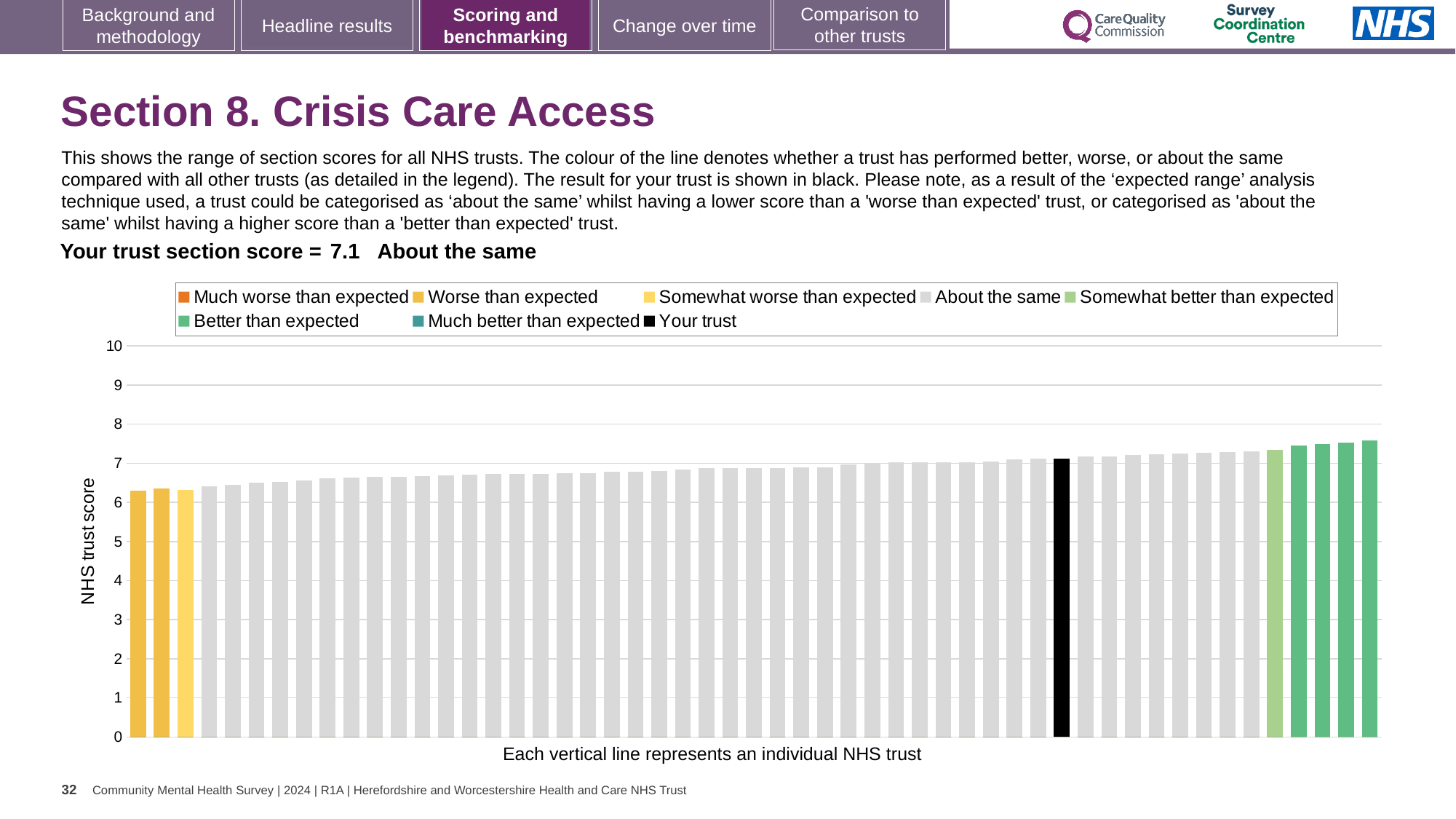
What is the section score for your trust shown on the slide? 7.1 Which legend category does the tallest bar on the chart belong to? Better than expected What is the label on the vertical axis of the chart? NHS trust score How many bars are coloured as 'Better than expected'? 4 Do the bar values rise or fall from left to right along the x axis? rise What colour is the bar representing your trust? black How many entries does the chart legend list? 8 Which performance category is your trust placed in for Section 8? About the same What type of chart is shown on the slide? bar chart Is the value of the highest bar on the chart greater or less than 8? less Is the value of the lowest bar on the chart greater or less than 6? greater Is the value for your trust (the black bar) greater or less than 5? greater